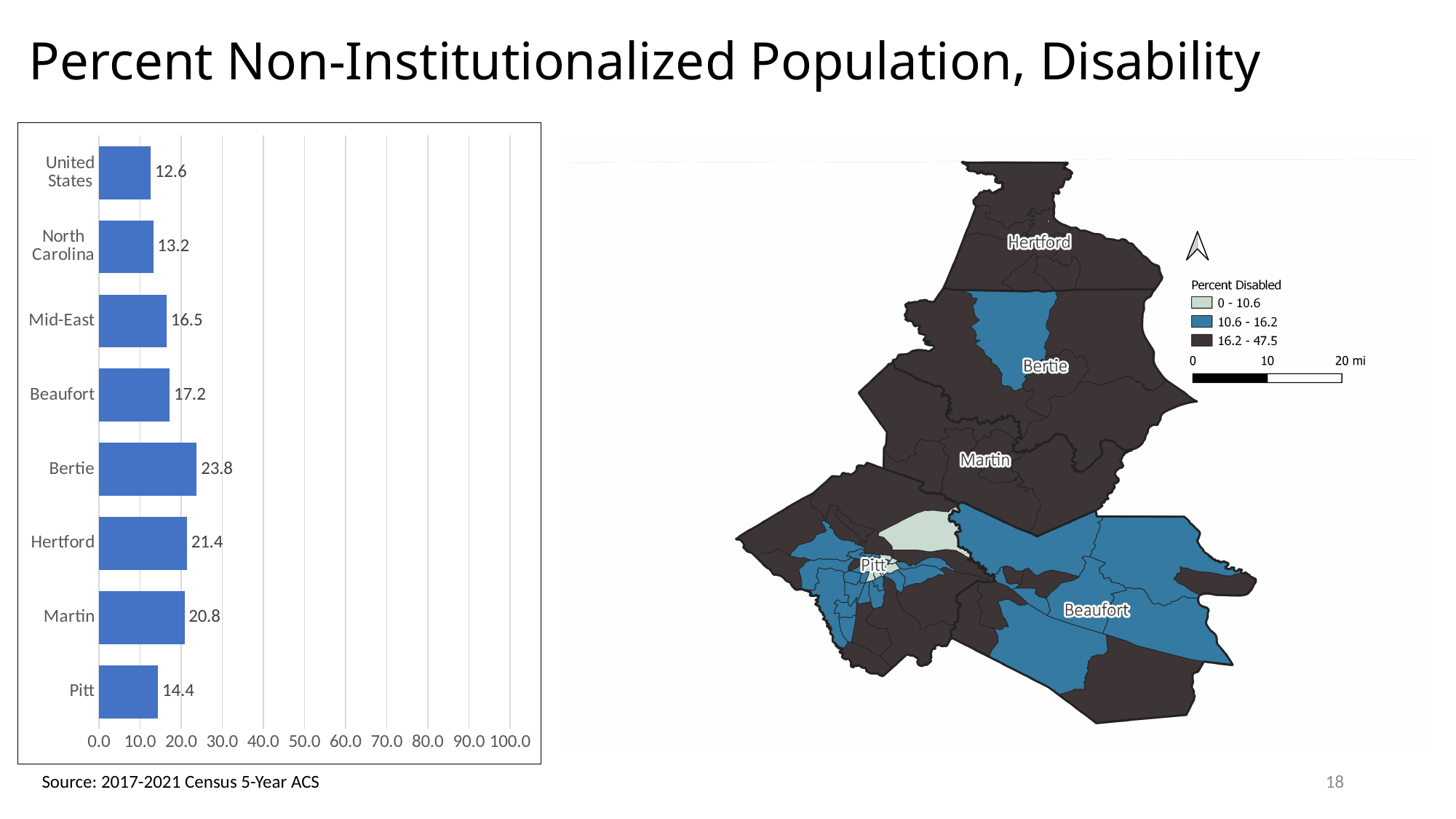
What is the difference between the values for Bertie and Pitt in the bar chart? 9.4 Which category has the lowest value in the bar chart? United States How many categories are shown in the bar chart? 8 Is the value for Martin in the bar chart greater or less than 20.0? greater What is the value for the United States in the bar chart? 12.6 What is the value for Bertie in the bar chart? 23.8 What is the value for Pitt in the bar chart? 14.4 What is the difference between the values for Hertford and Martin in the bar chart? 0.6 What is the highest value shown on the x axis of the bar chart? 100.0 Which has a larger value in the bar chart, Beaufort or Mid-East? Beaufort What kind of chart is shown on the left of the slide? Bar chart Which category has the highest value in the bar chart? Bertie